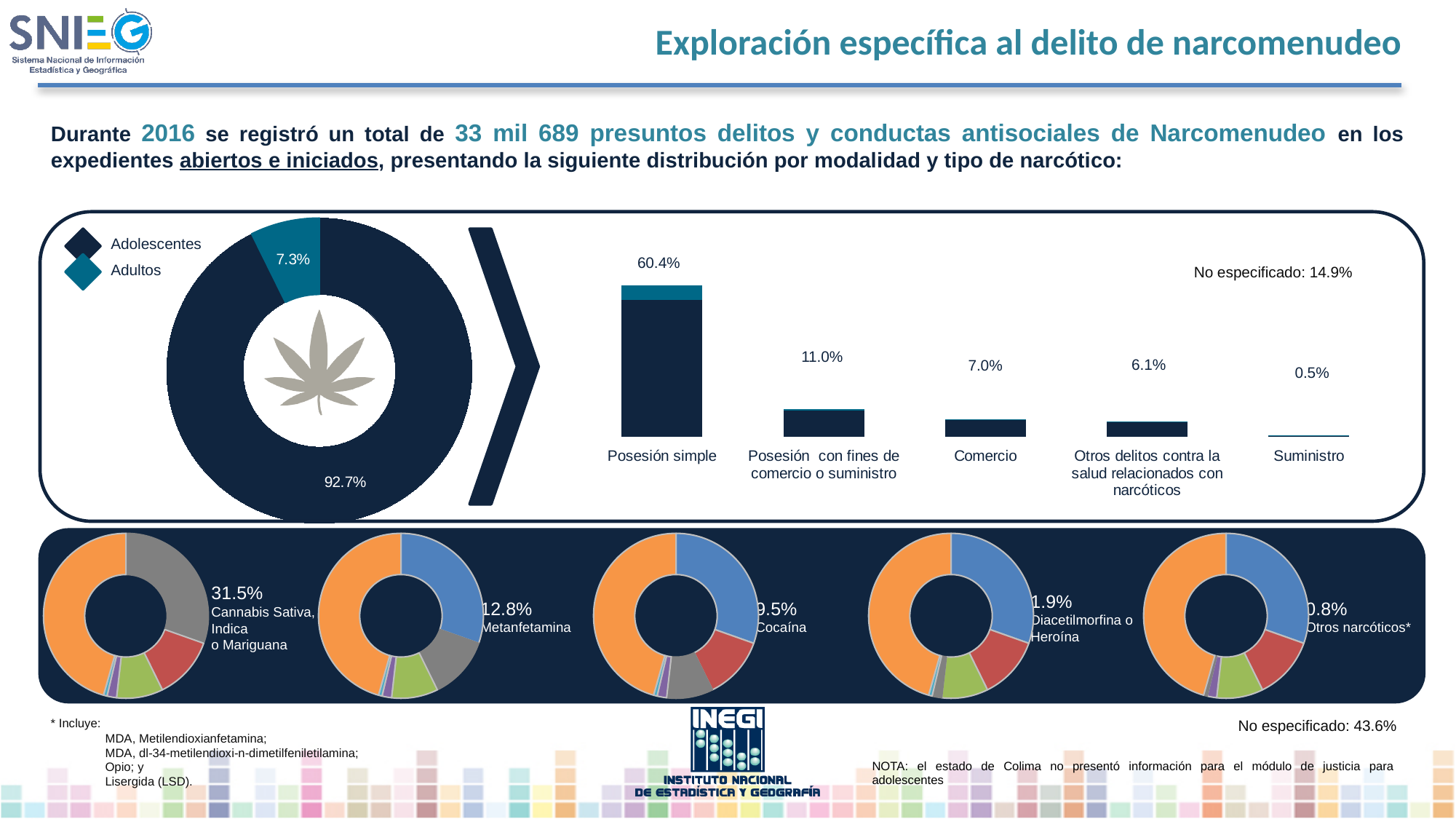
In the bar chart by modality, what is the value for Posesión simple? 60.4% What kind of chart is used to show the distribution by modality (Posesión simple, Comercio, etc.)? Bar chart In the bar chart by modality, which category has the highest value? Posesión simple How many categories does the bar chart by modality show? 5 In the bar chart by modality, what is the value for Comercio? 7.0% In the bar chart by modality, what is the difference between Posesión simple and Posesión con fines de comercio o suministro? 49.4% In the bar chart by modality, which category has the lowest value? Suministro How many entries does the legend of the donut chart on the left list? 2 In the bar chart by modality, what is the value for Suministro? 0.5%